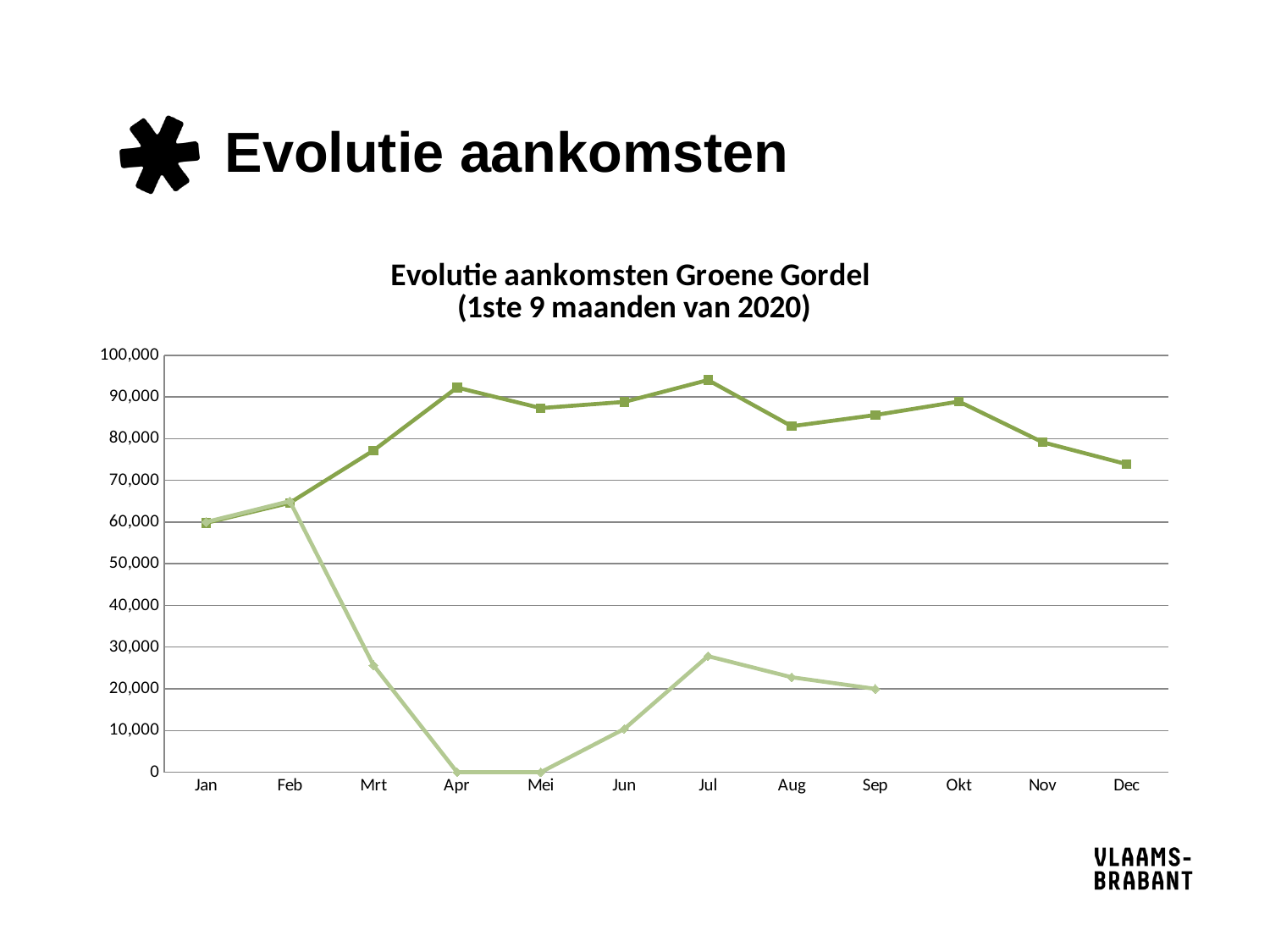
What kind of chart is shown on the slide? line chart In which month does the darker green line reach its highest value? Jul Is the value of the lighter green line in Apr greater or less than 10,000? less How many data points does the lighter green line have? 9 Is the value of the darker green line in Jul greater or less than 90,000? greater How many months are labelled along the x axis? 12 Does the lighter green line rise or fall from Feb to Apr? fall What is the title of the chart? Evolutie aankomsten Groene Gordel (1ste 9 maanden van 2020) In which month does the lighter green line reach its highest value? Feb Is the value of the darker green line in Dec greater or less than 80,000? less In which month does the darker green line have its lowest value? Jan